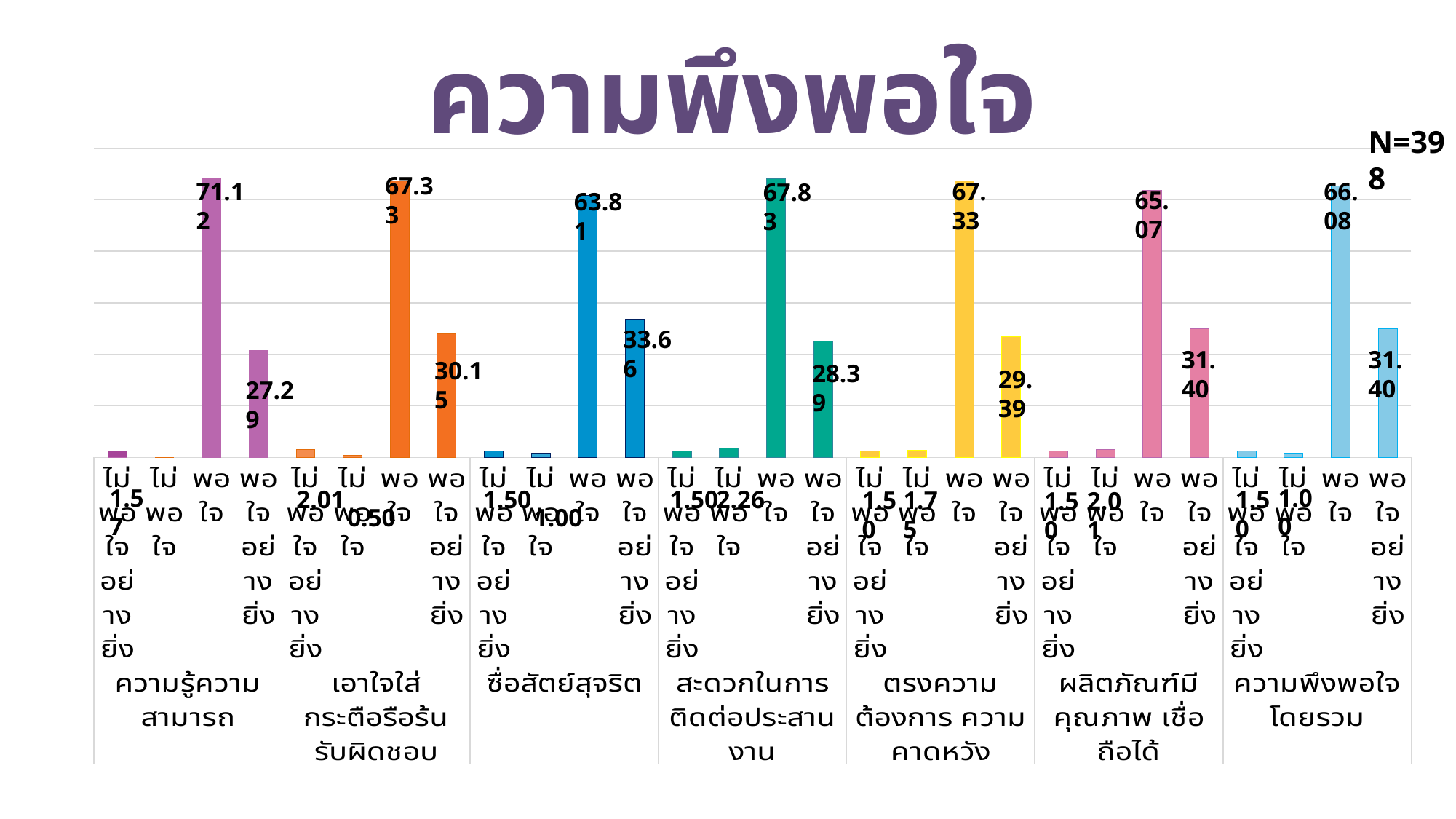
Which is larger: the พอใจอย่างยิ่ง value in เอาใจใส่กระตือรือร้นรับผิดชอบ or in ตรงความต้องการ ความคาดหวัง? เอาใจใส่กระตือรือร้นรับผิดชอบ How many category groups are shown along the x axis? 7 Which group has the lowest พอใจ value? ซื่อสัตย์สุจริต What is the difference between the พอใจ value in ความรู้ความสามารถ (71.12) and the พอใจ value in ซื่อสัตย์สุจริต (63.81)? 7.31 What is the value of the พอใจอย่างยิ่ง bar in the ผลิตภัณฑ์มีคุณภาพ เชื่อถือได้ group? 31.40 What is the value of the พอใจ bar in the ความพึงพอใจโดยรวม group? 66.08 What sample size (N) is shown on the slide? N=398 Which group has the highest พอใจ value? ความรู้ความสามารถ What is the title of the chart? ความพึงพอใจ What is the value of the พอใจ bar in the ความรู้ความสามารถ group? 71.12 What kind of chart is shown on the slide? Bar chart What is the value of the พอใจอย่างยิ่ง bar in the ซื่อสัตย์สุจริต group? 33.66